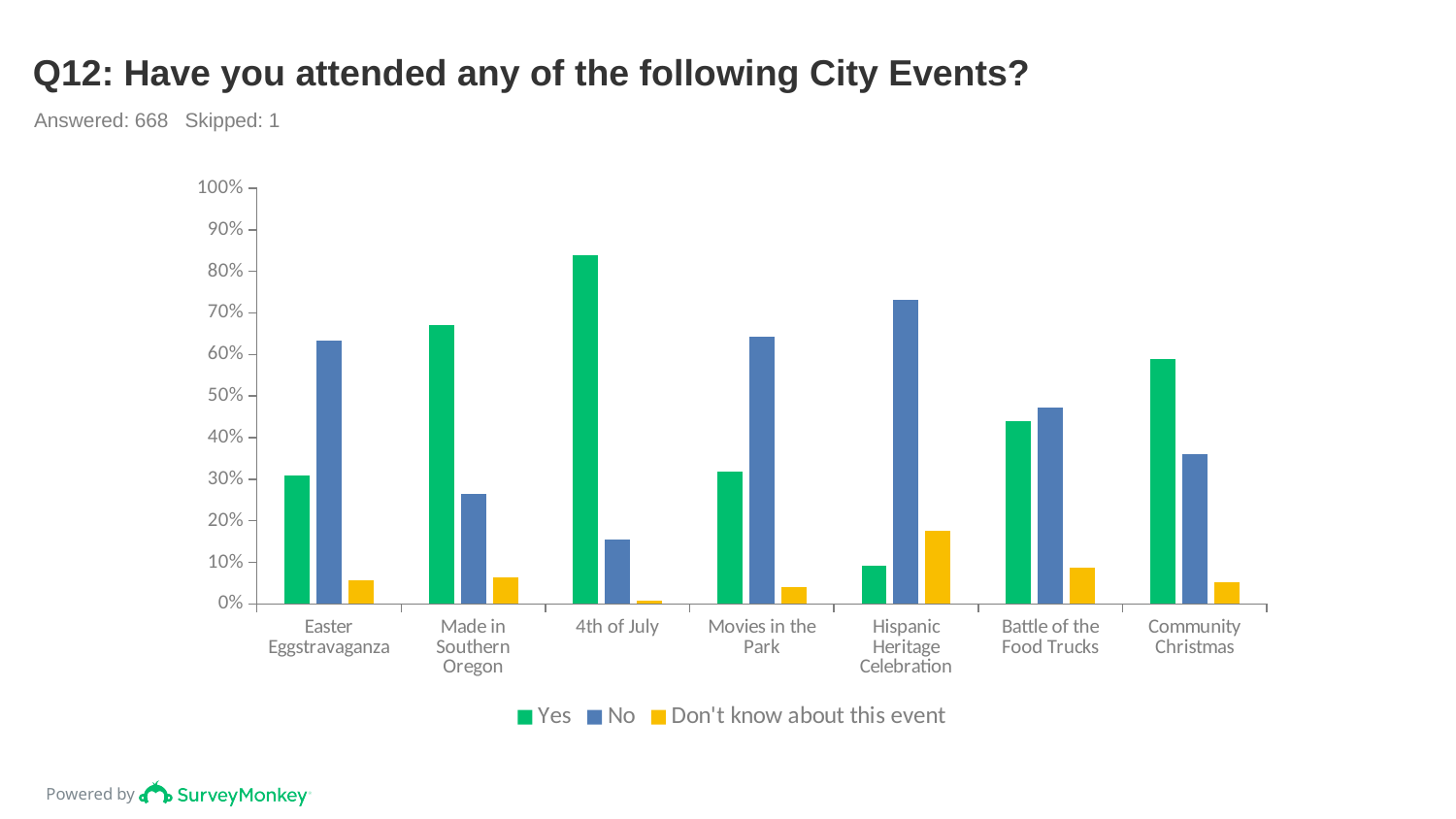
Is the "Yes" value for Community Christmas greater or less than 50%? greater Which event has the lowest "Yes" value? Hispanic Heritage Celebration How many city events are shown on the x axis? 7 What kind of chart is shown on the slide? bar chart Which event has the highest "No" value? Hispanic Heritage Celebration Is the "No" value for Made in Southern Oregon greater or less than 30%? less What is the title of the chart? Q12: Have you attended any of the following City Events? How many series does the legend list? 3 Is the "Yes" value for 4th of July greater or less than 80%? greater For Easter Eggstravaganza, which is larger, the "Yes" value or the "No" value? No Which event has the highest "Don't know about this event" value? Hispanic Heritage Celebration Which event has the highest "Yes" value? 4th of July